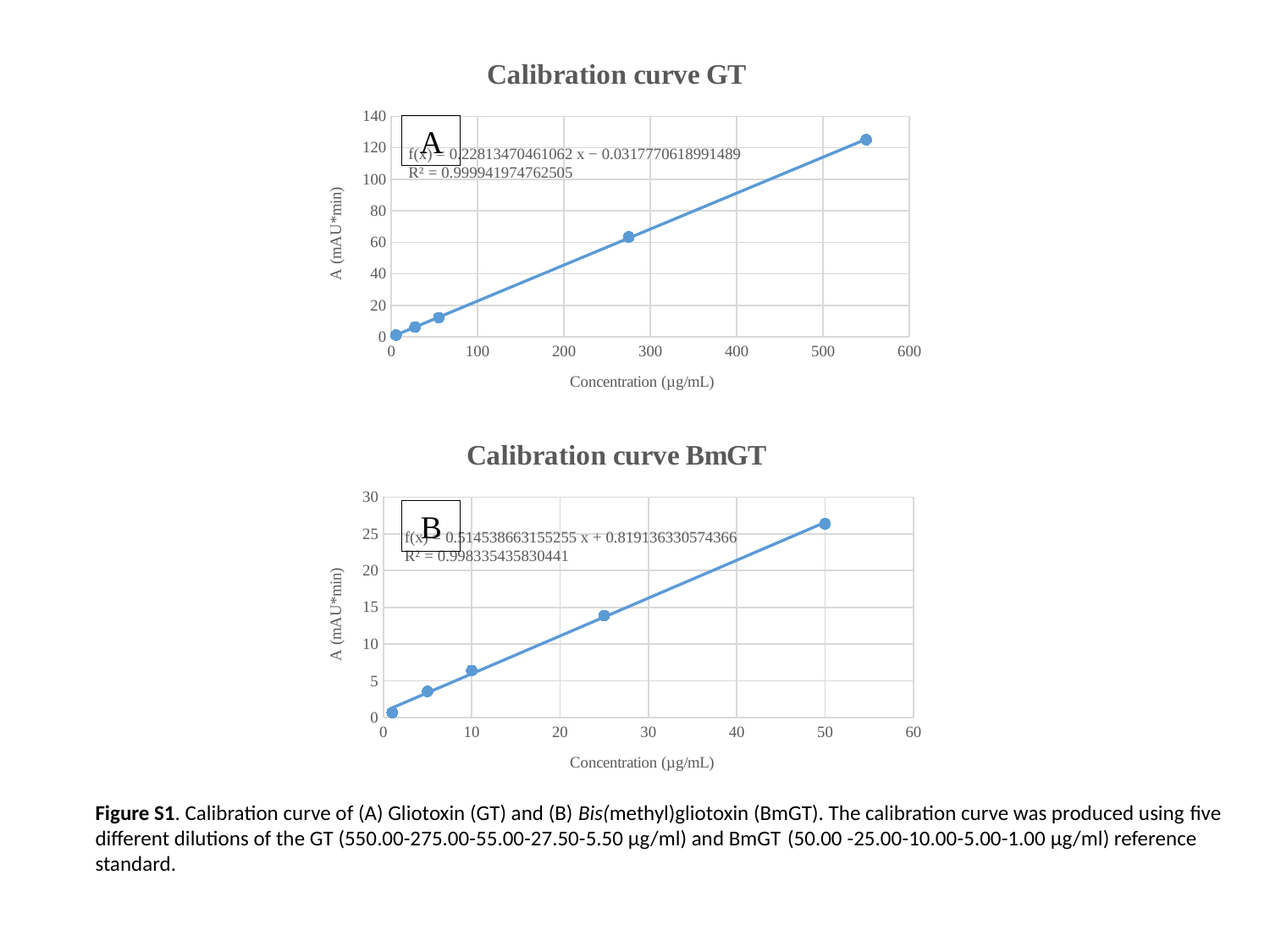
What is the y-axis label of the 'Calibration curve BmGT' chart? A (mAU*min) In the 'Calibration curve GT' chart, do the values rise or fall as concentration increases? Rise How many data points are plotted in the 'Calibration curve BmGT' chart? 5 In the 'Calibration curve GT' chart, is the value at a concentration of 275 µg/mL greater or less than 80? less In the 'Calibration curve BmGT' chart, is the value at a concentration of 50 µg/mL greater or less than 20? greater What R² value is shown on the 'Calibration curve GT' chart? 0.999941974762505 In the 'Calibration curve BmGT' chart, is the value at a concentration of 10 µg/mL greater or less than 5? greater In the 'Calibration curve BmGT' chart, do the values rise or fall as concentration increases? Rise How many data points are plotted in the 'Calibration curve GT' chart? 5 What type of chart is the 'Calibration curve GT' chart? Scatter chart with a trendline